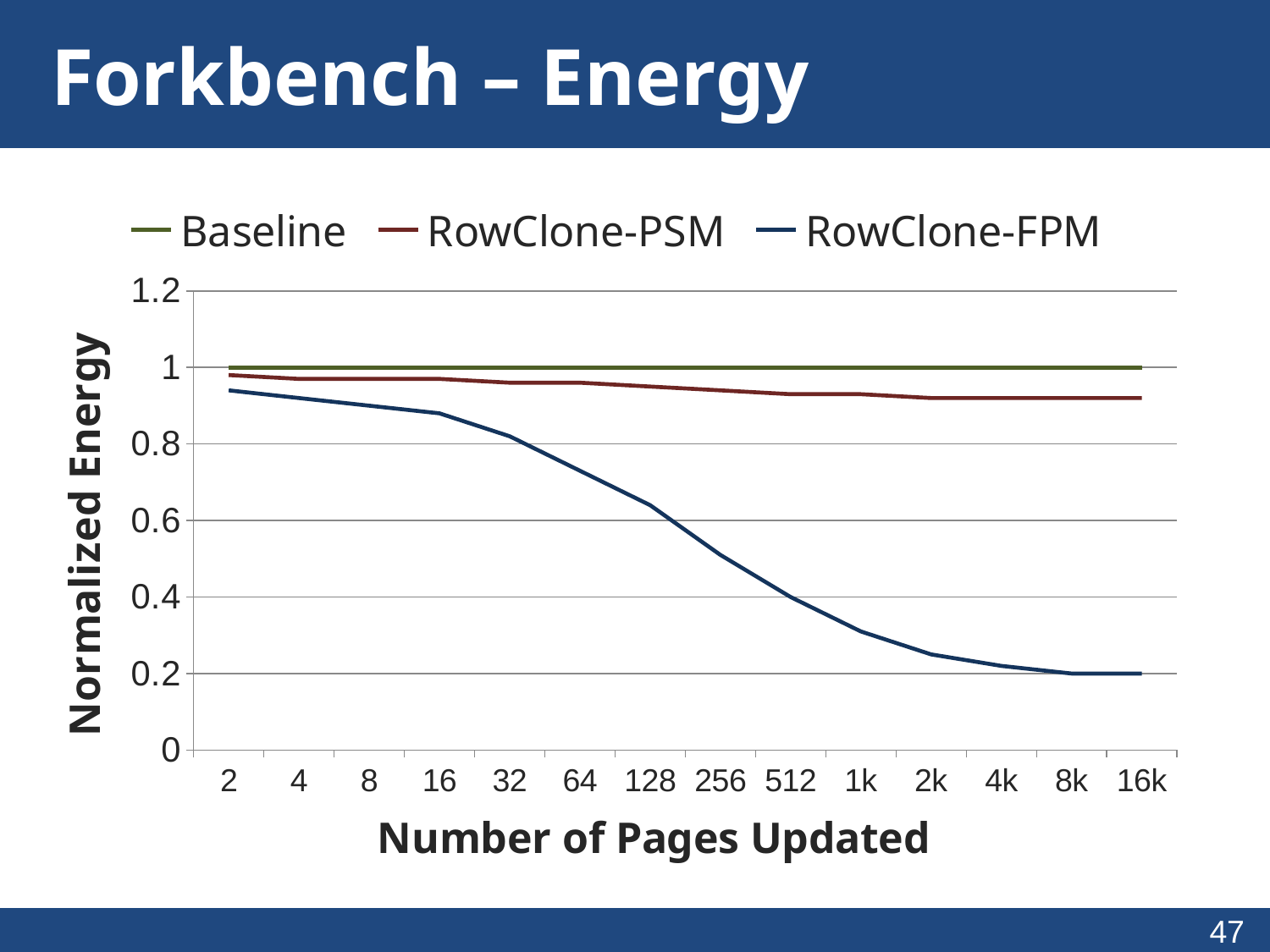
At 128 pages updated, which series has the higher normalized energy, RowClone-PSM or RowClone-FPM? RowClone-PSM Is the RowClone-PSM value at 16k pages greater or less than 0.8? greater How many points are on the x axis (Number of Pages Updated)? 14 Does the RowClone-FPM line rise or fall as the number of pages updated increases? fall What is the title of the y axis? Normalized Energy Is the RowClone-FPM value at 16 pages greater or less than 0.8? greater What kind of chart is shown on the slide? line chart What is the Baseline normalized energy at 2 pages updated? 1 Is the RowClone-FPM value at 128 pages greater or less than 0.8? less How many series does the legend list? 3 Which series has the lowest normalized energy at 16k pages updated? RowClone-FPM